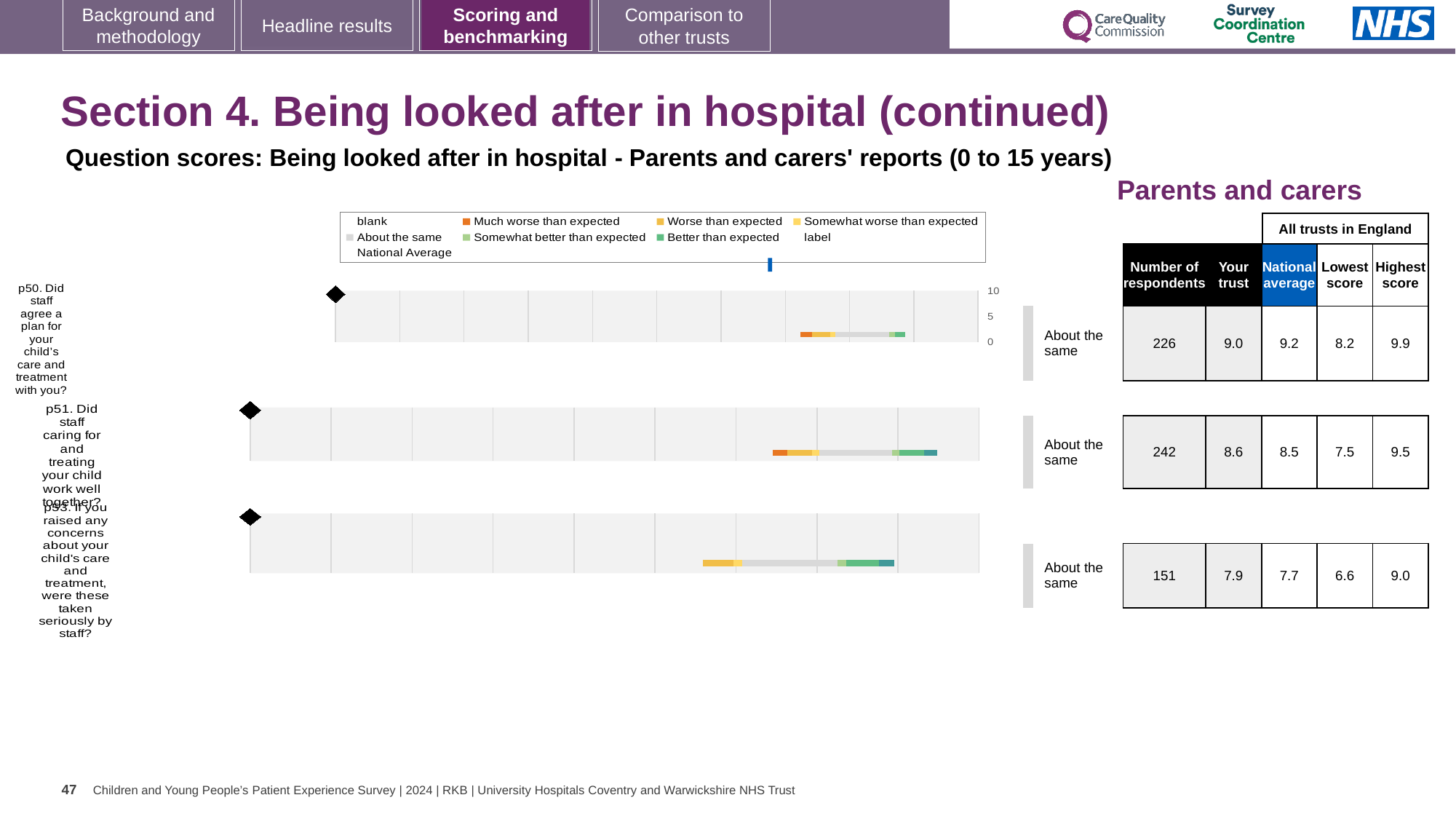
How many respondents answered p53 (If you raised any concerns about your child's care and treatment, were these taken seriously by staff?)? 151 Which colour in the legend represents 'Much worse than expected'? orange For p50, what is the difference between the highest score and the lowest score across all trusts in England? 1.7 What is the 'Your trust' score for p50 (Did staff agree a plan for your child's care and treatment with you?)? 9.0 What benchmark category is shown next to each of the three questions on this slide? About the same Which question has the lowest 'Your trust' score on this slide? p53 What is the highest score across all trusts in England for p53? 9.0 What kind of chart is used to show the question scores on this slide? bar chart Which question has the highest 'Your trust' score on this slide? p50 How many survey questions are plotted in the benchmarking charts on this slide? 3 For p51, is the 'Your trust' score or the national average higher? Your trust What is the national average score for p51 (Did staff caring for and treating your child work well together?)? 8.5